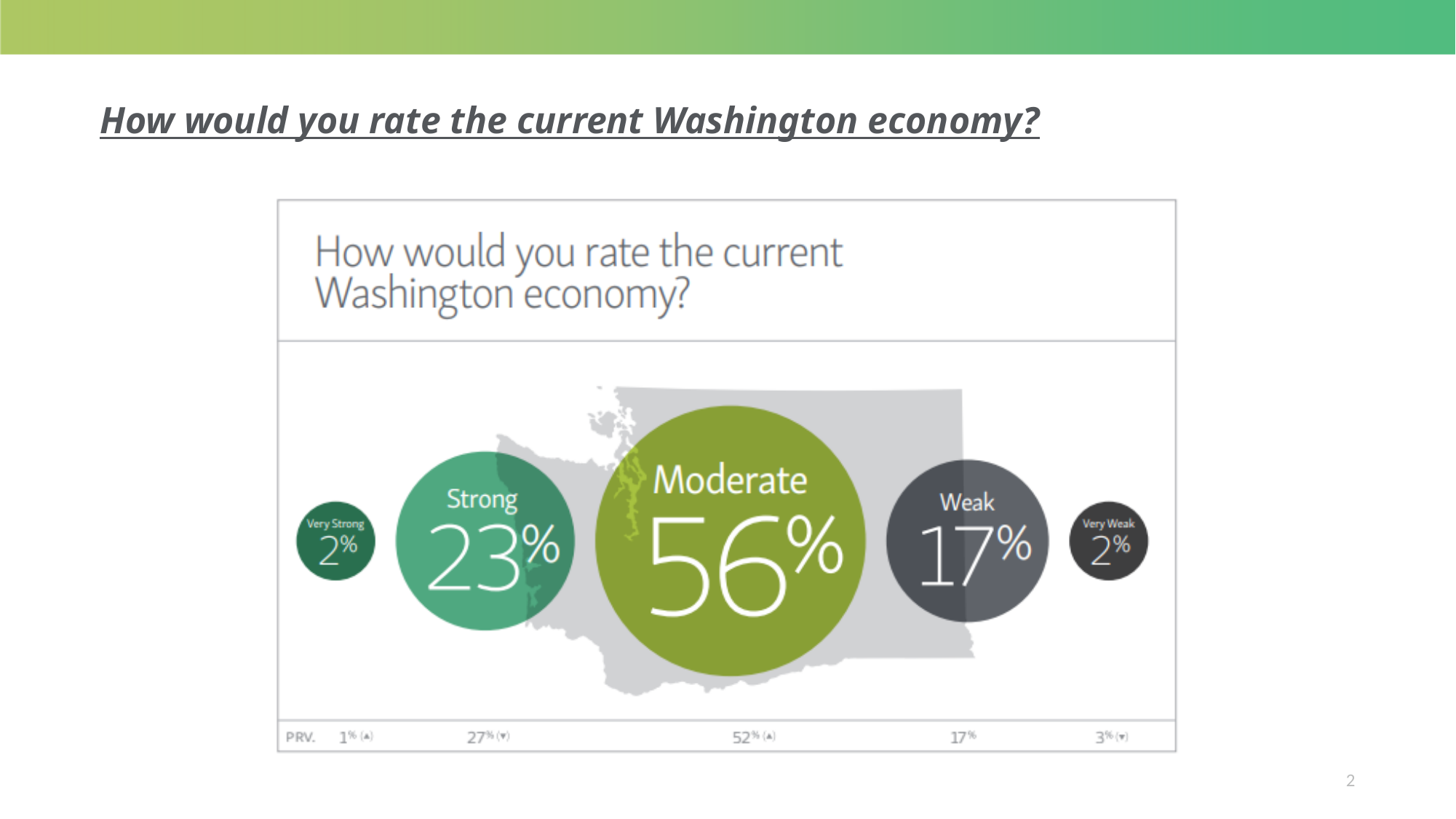
Which rating category received the highest share of responses? Moderate What percentage of respondents rated the Washington economy as Weak? 17% What was the previous (PRV.) value for the Strong rating? 27% What is the title of the chart? How would you rate the current Washington economy? How many rating categories are shown in the chart? 5 What percentage of respondents rated the Washington economy as Strong? 23% What was the previous (PRV.) value for the Moderate rating? 52% What percentage of respondents rated the Washington economy as Very Strong? 2% What is the difference in percentage points between the Moderate and Strong ratings? 33 What percentage of respondents rated the current Washington economy as Moderate? 56% Which received a larger share of responses, Strong or Weak? Strong What is the difference in percentage points between the Strong and Weak ratings? 6